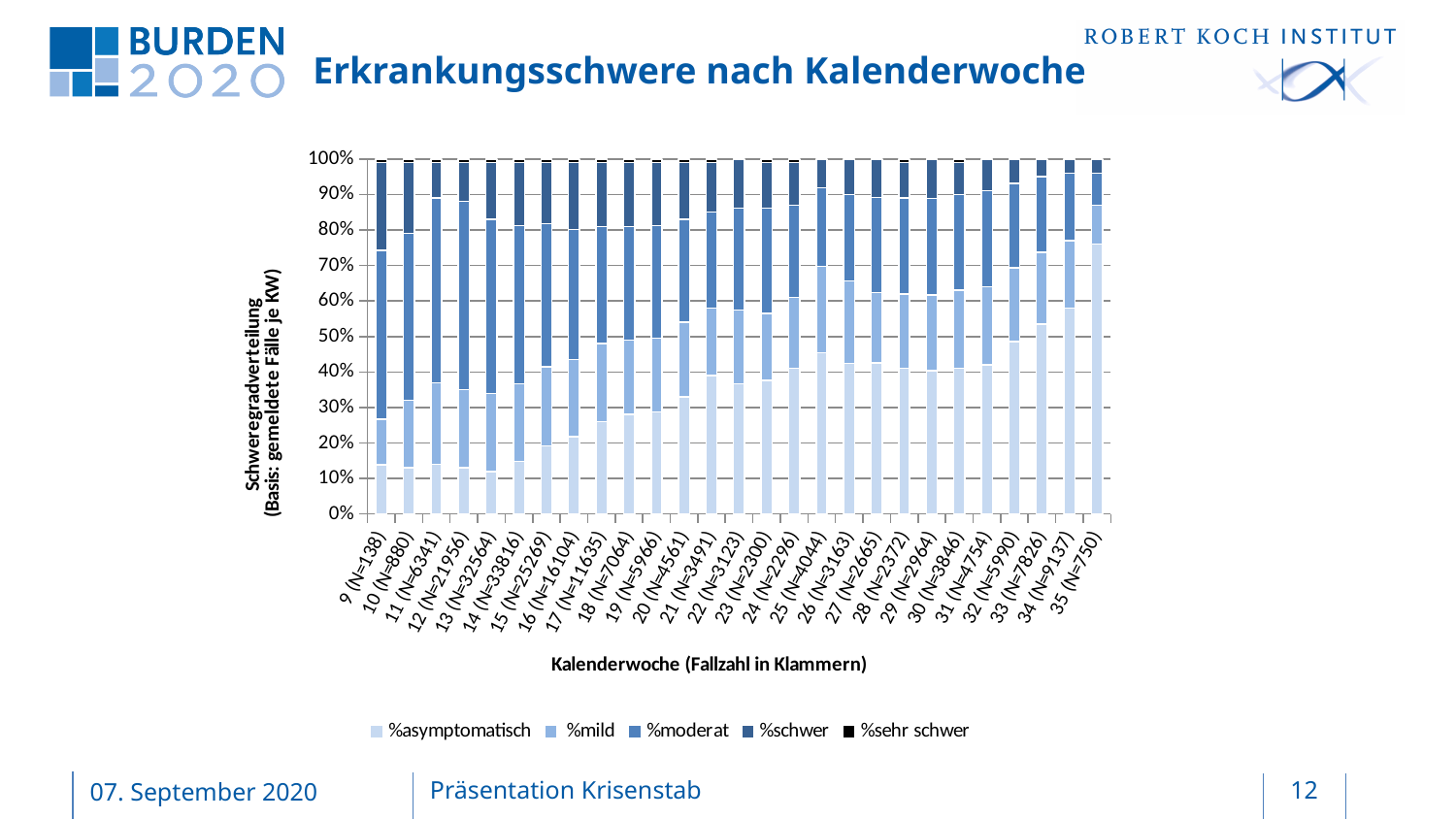
What kind of chart is shown on the slide? stacked bar chart What is the case number (N) given in the label for calendar week 13? 32564 Which calendar week has the largest %asymptomatisch share? 35 (N=750) How many series does the legend list? 5 Is the %asymptomatisch share for calendar week 34 greater or less than 50%? greater Is the %asymptomatisch share for calendar week 9 greater or less than 20%? less What is the case number (N) given in the label for calendar week 35? 750 How many calendar weeks (categories) are plotted on the x axis? 27 What is the case number (N) given in the label for calendar week 9? 138 Does the %asymptomatisch share generally rise or fall from calendar week 9 to calendar week 35? rise What is the title of the x axis? Kalenderwoche (Fallzahl in Klammern) Is the %asymptomatisch share for calendar week 35 greater or less than 70%? greater